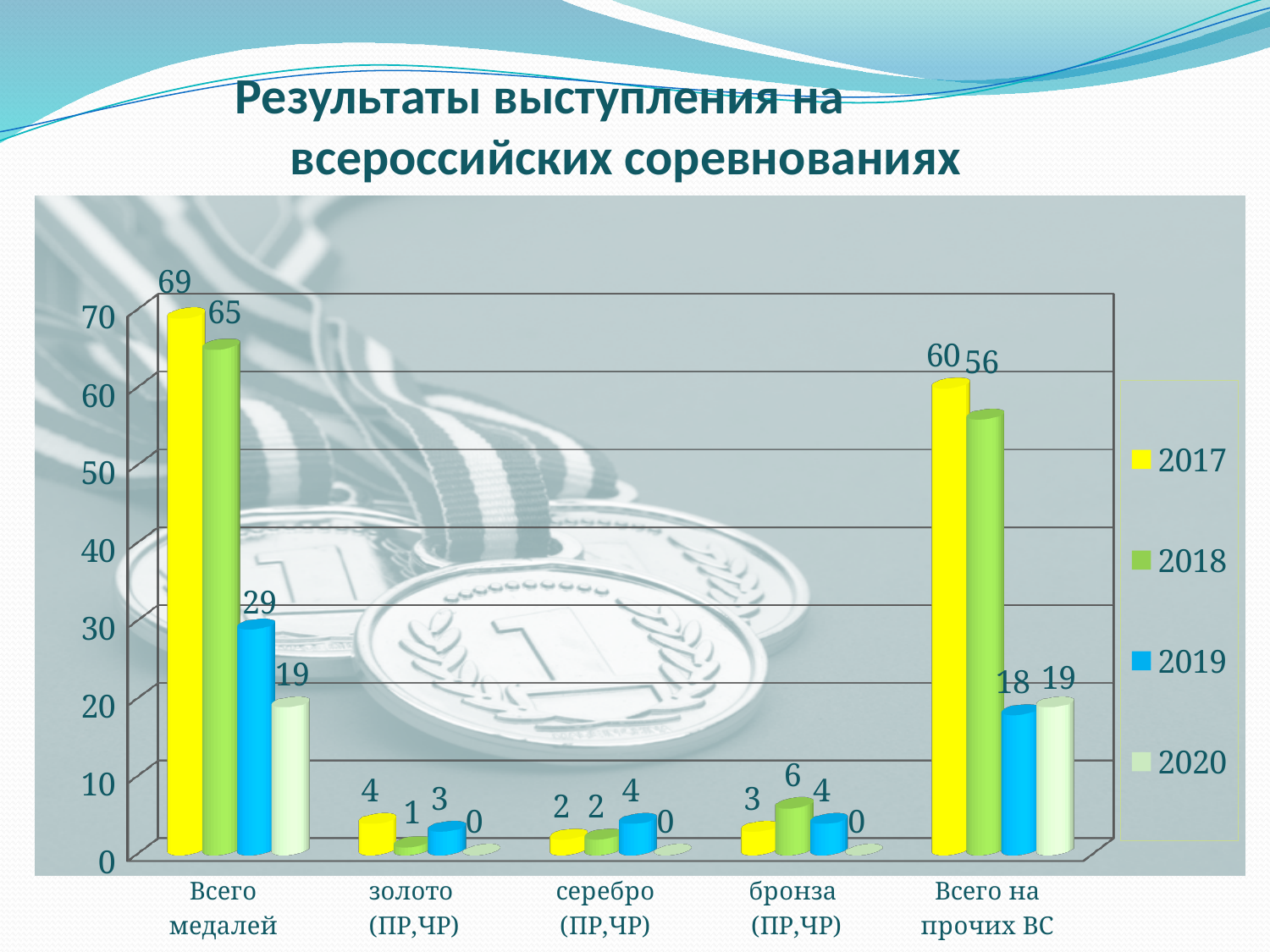
What is the value for 2017 in the "Всего медалей" category? 69 Which year has the lowest value in the "серебро (ПР,ЧР)" category? 2020 How many categories are shown on the x axis? 5 What is the value for 2020 in the "золото (ПР,ЧР)" category? 0 Which colour represents the 2019 series in the legend? Blue How many series does the legend list? 4 What kind of chart is shown on the slide? Bar chart What is the value for 2019 in the "Всего на прочих ВС" category? 18 What is the difference between the 2017 and 2018 values in the "Всего на прочих ВС" category? 4 What is the value for 2018 in the "бронза (ПР,ЧР)" category? 6 Which year has the highest value in the "Всего медалей" category? 2017 Which is larger in the "Всего медалей" category: the value for 2019 or the value for 2020? 2019